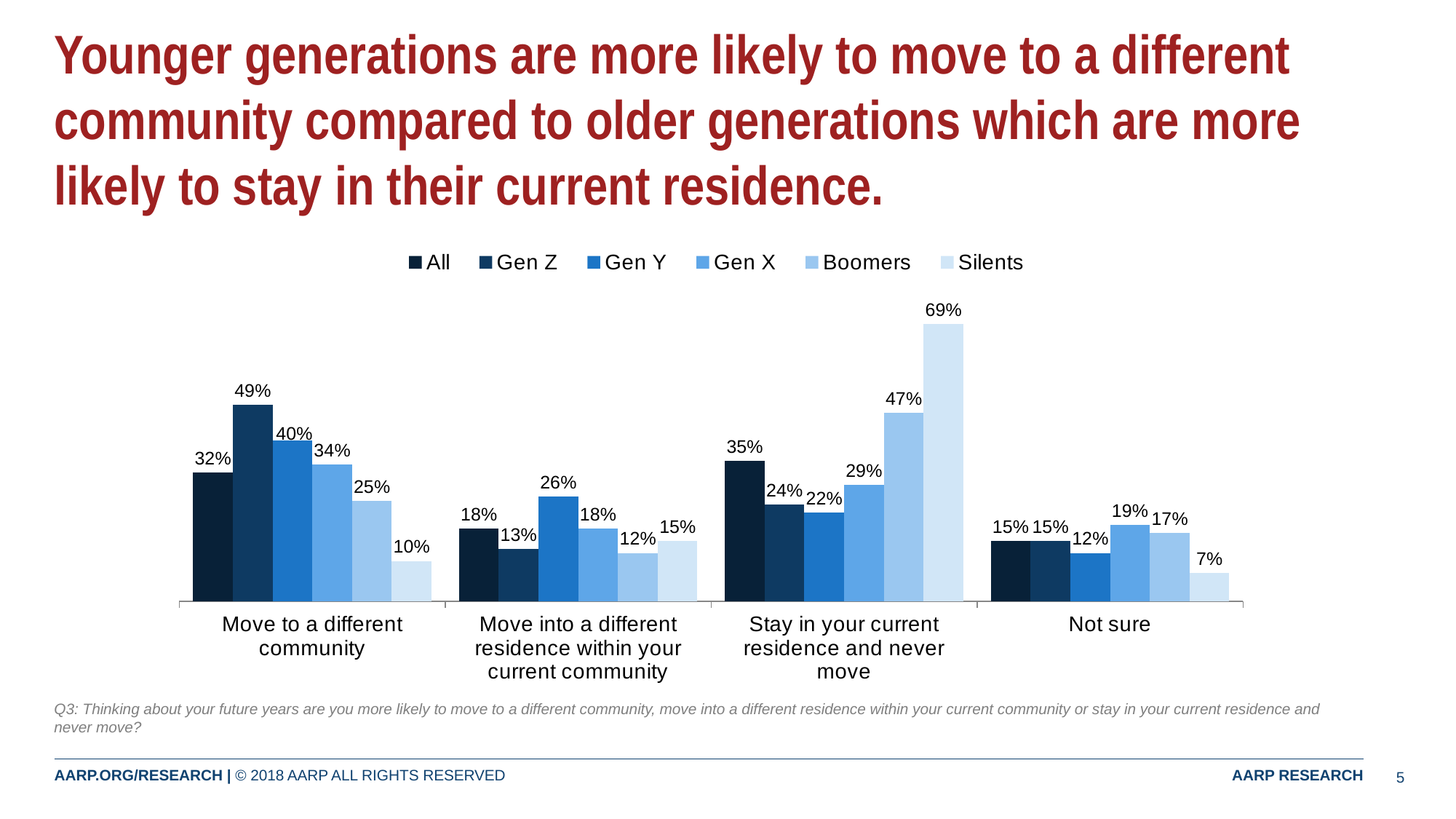
Which generation has the highest value for 'Stay in your current residence and never move'? Silents What percentage of Gen Z respondents say they would move to a different community? 49% Within the 'Stay in your current residence and never move' category, do the values rise or fall from Gen Y to Silents? Rise How many series does the legend list? 6 Which is larger: the Gen Y value for 'Move into a different residence within your current community' or the Gen Y value for 'Stay in your current residence and never move'? Move into a different residence within your current community What is the value for Silents in the 'Stay in your current residence and never move' category? 69% How many response categories are shown on the x axis? 4 What kind of chart is shown on the slide? Bar chart What is the difference between the Gen Z and Silents values for 'Move to a different community'? 39% What percentage of Boomers say they would move into a different residence within their current community? 12% What is the value for All respondents in the 'Not sure' category? 15% Which generation has the lowest value in the 'Not sure' category? Silents